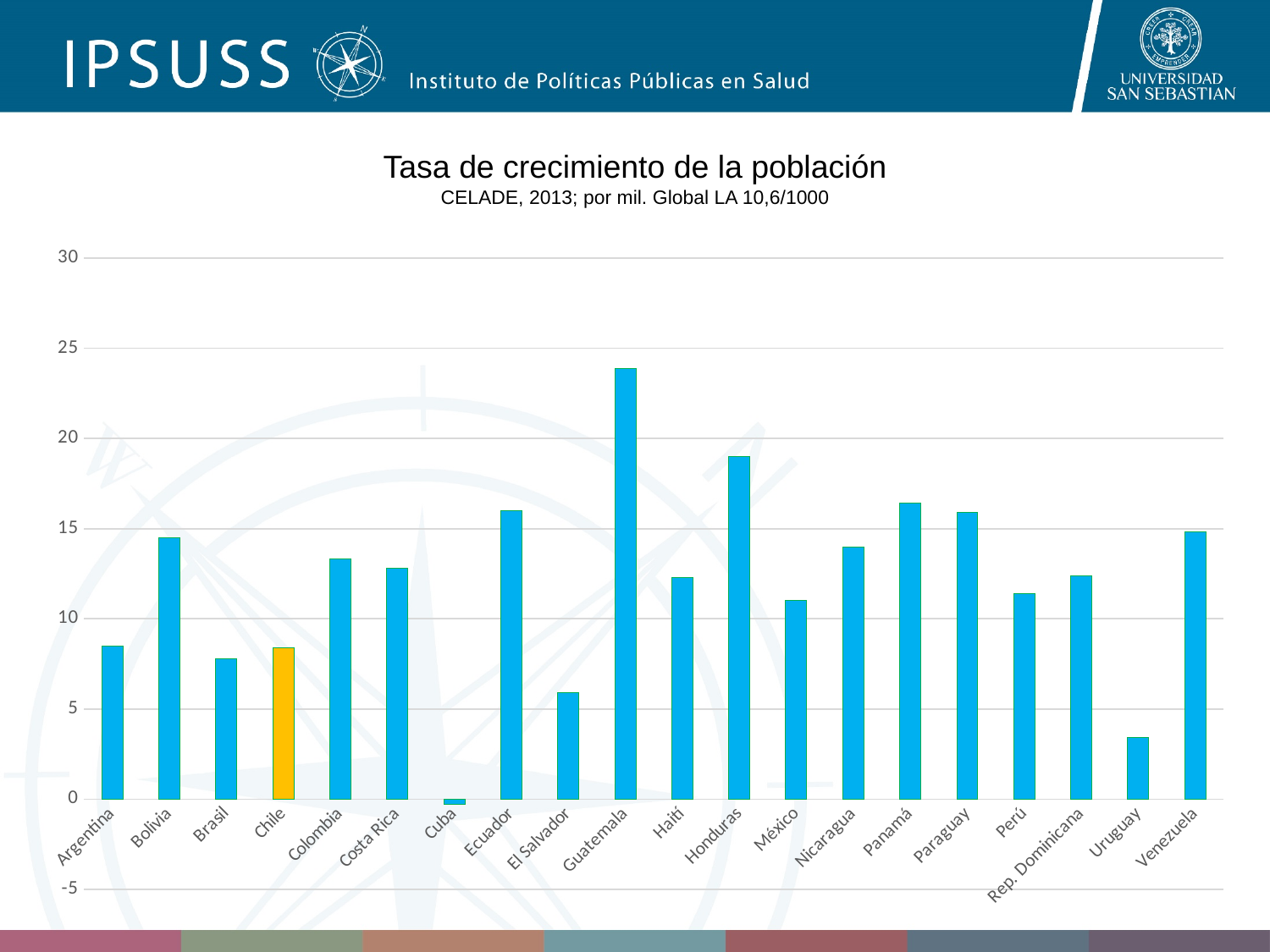
Which country's bar is coloured differently (orange) from the others? Chile What is the title of the chart? Tasa de crecimiento de la población Is the value for Honduras greater or less than 15? greater Is the value for Uruguay greater or less than 5? less Is the value for Chile greater or less than 10? less Which country has the lowest population growth rate in the chart? Cuba What kind of chart is shown on the slide? Bar chart How many countries are shown on the x axis of the chart? 20 Which has a higher value, Bolivia or Brasil? Bolivia Which country has the highest population growth rate in the chart? Guatemala Which has a higher value, Guatemala or Honduras? Guatemala